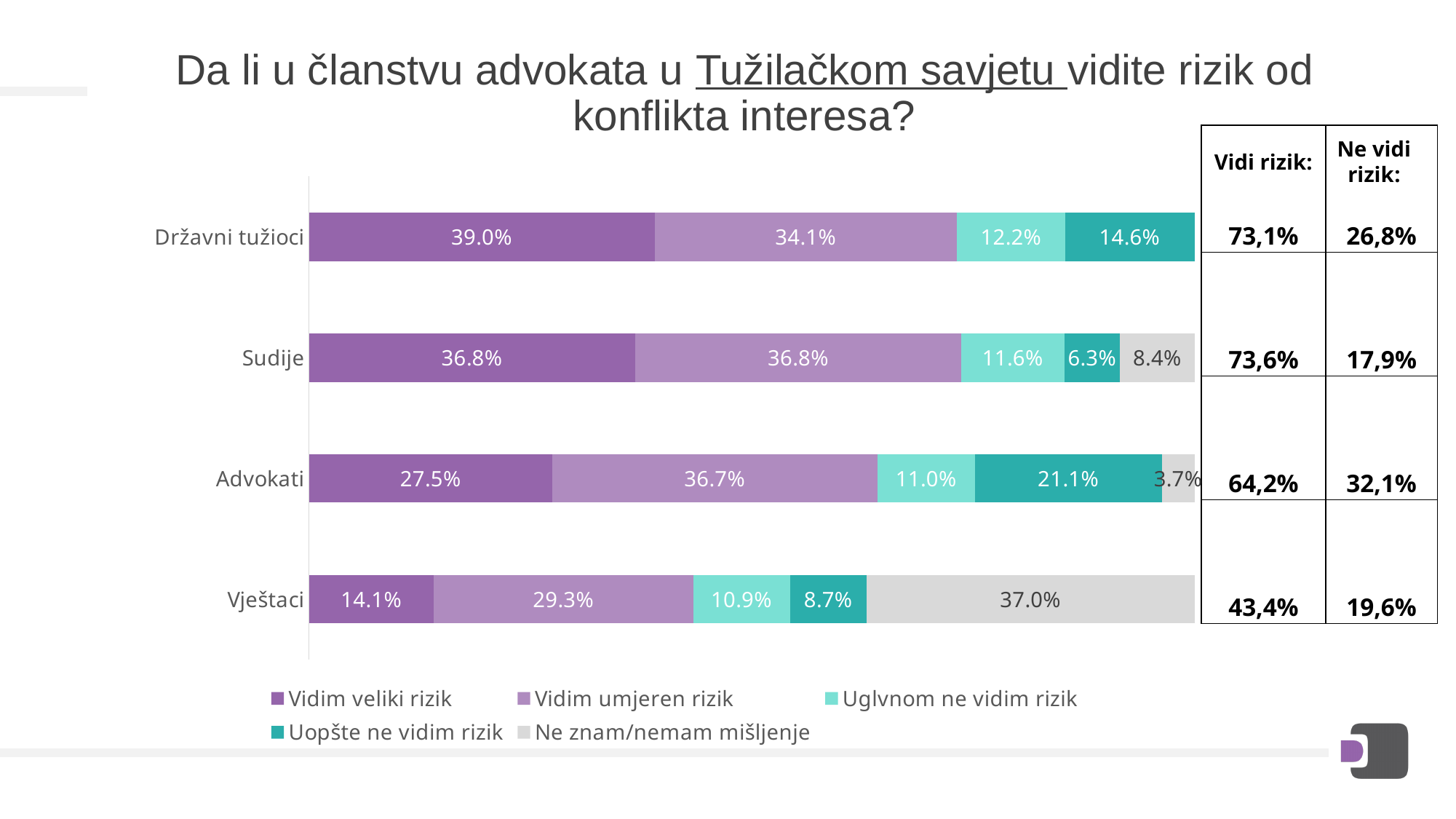
What is the difference in "Uopšte ne vidim rizik" between Advokati and Sudije? 14.8 percentage points How many categories (respondent groups) are shown on the chart? 4 What percentage of Državni tužioci answered "Vidim veliki rizik"? 39.0% What kind of chart is shown on the slide? Stacked bar chart What is the total of the stacked bar for Vještaci? 100.0% Which category has the highest value for "Vidim veliki rizik"? Državni tužioci What is the difference in "Vidim veliki rizik" between Državni tužioci and Vještaci? 24.9 percentage points Which category has the lowest value for "Vidim veliki rizik"? Vještaci What percentage of Advokati answered "Uopšte ne vidim rizik"? 21.1% What is the value of "Ne znam/nemam mišljenje" for Vještaci? 37.0% How many series does the legend list? 5 Which is larger: "Uglvnom ne vidim rizik" for Državni tužioci or for Vještaci? Državni tužioci